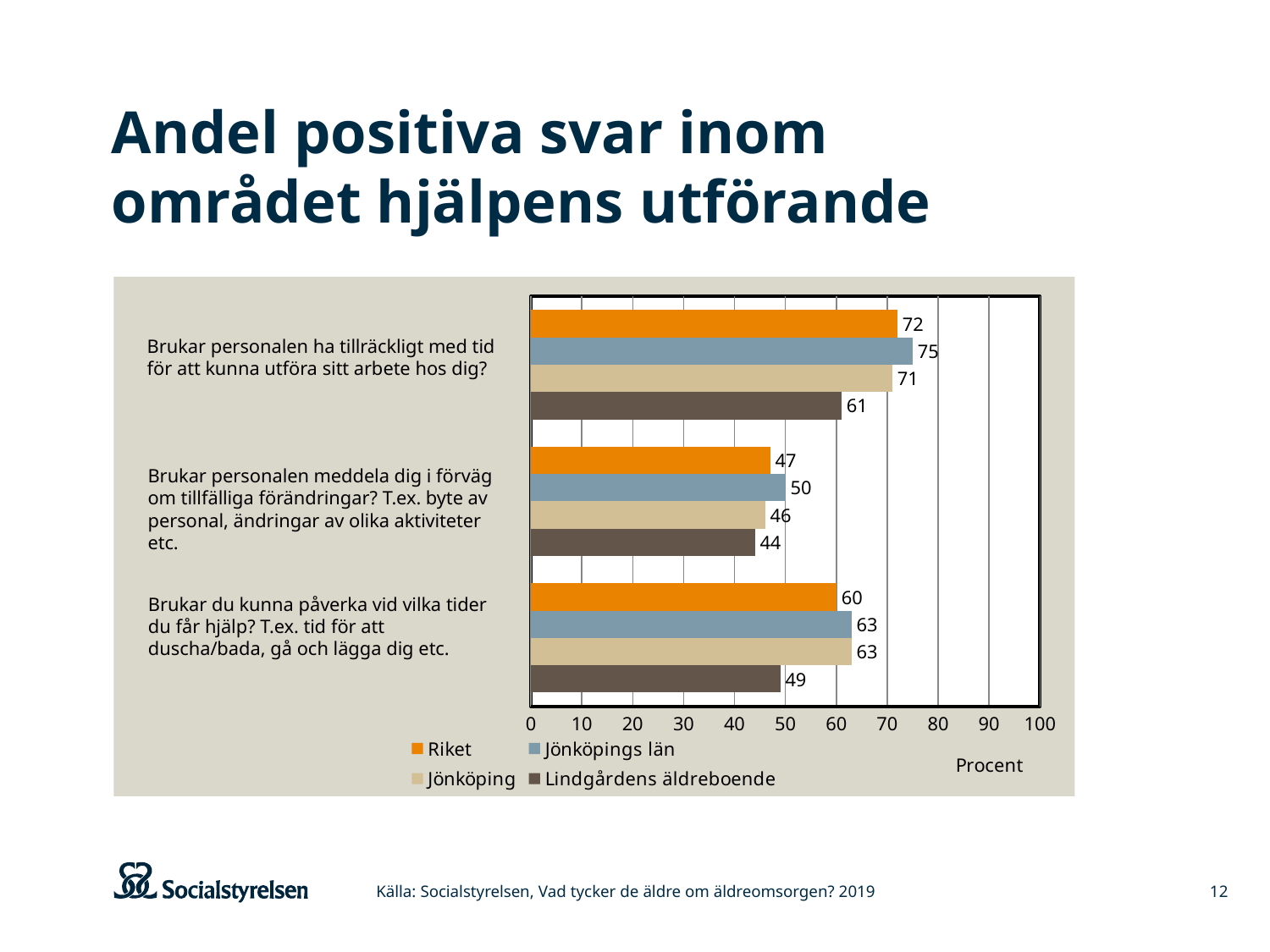
Which series has the highest value for the question "Brukar personalen meddela dig i förväg om tillfälliga förändringar?"? Jönköpings län What type of chart is shown on the slide? bar chart What is the value for Jönköpings län for the question "Brukar personalen ha tillräckligt med tid för att kunna utföra sitt arbete hos dig?"? 75 How many question categories are plotted on the chart? 3 How many series does the legend list? 4 What is the difference between Jönköping and Lindgårdens äldreboende for the question "Brukar du kunna påverka vid vilka tider du får hjälp?"? 14 For the question "Brukar personalen ha tillräckligt med tid för att kunna utföra sitt arbete hos dig?", which is larger: Riket or Jönköping? Riket What is the value for Lindgårdens äldreboende for the question "Brukar du kunna påverka vid vilka tider du får hjälp?"? 49 What label is shown on the horizontal axis of the chart? Procent Is the value for Lindgårdens äldreboende for the question "Brukar personalen meddela dig i förväg om tillfälliga förändringar?" greater or less than 50? less Which series has the lowest value for the question "Brukar personalen ha tillräckligt med tid för att kunna utföra sitt arbete hos dig?"? Lindgårdens äldreboende What is the value for Riket for the question "Brukar personalen meddela dig i förväg om tillfälliga förändringar?"? 47